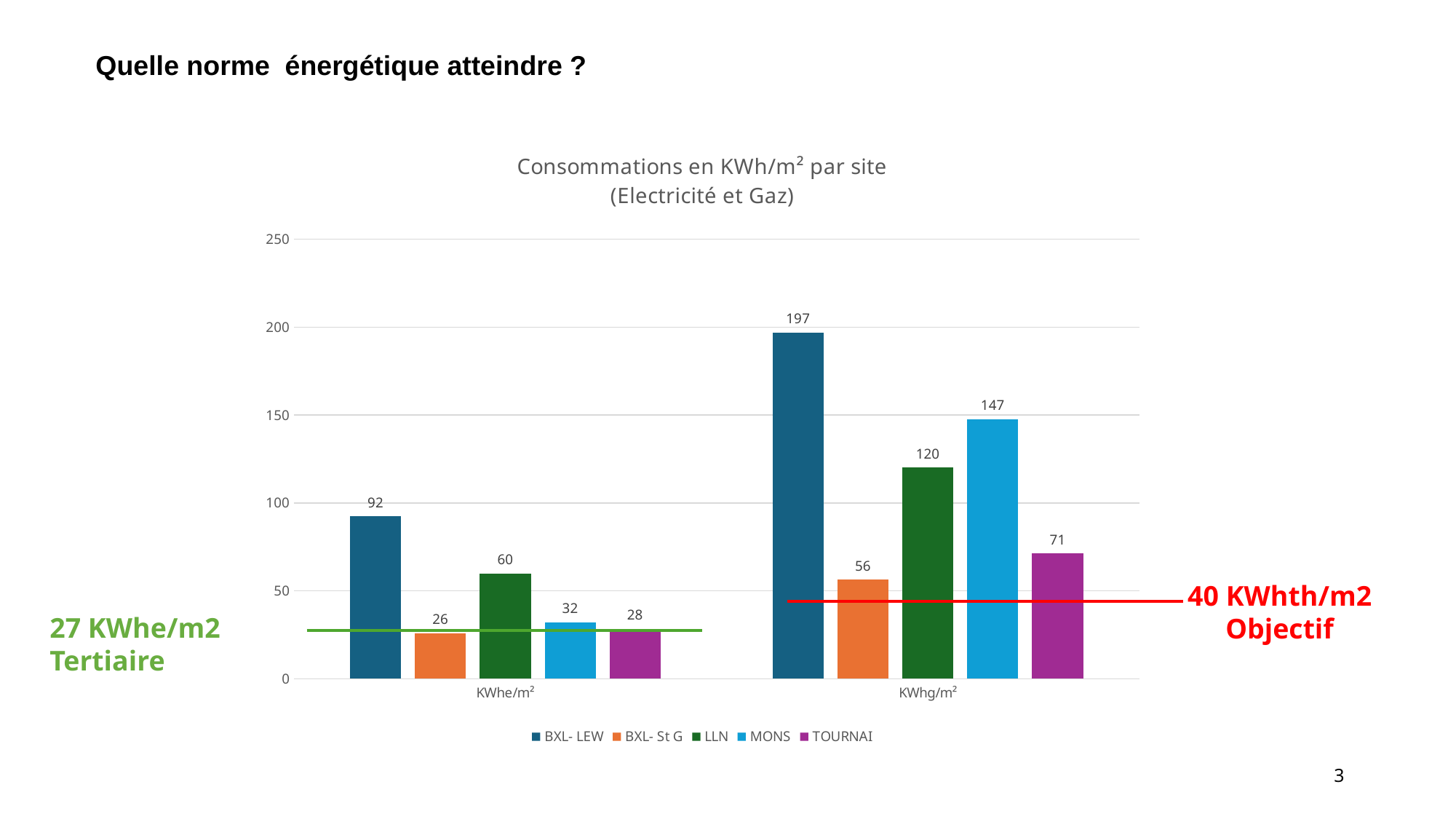
What is the difference between the KWhg/m² values for BXL- LEW and MONS? 50 How many series does the legend list? 5 What is the value for MONS in the KWhe/m² category? 32 Which is larger in the KWhe/m² category: LLN or MONS? LLN What is the value for TOURNAI in the KWhg/m² category? 71 How many categories are shown on the x axis? 2 What is the value for BXL- LEW in the KWhg/m² category? 197 Is the value for LLN in the KWhg/m² category greater or less than 100? greater Which site has the highest value in the KWhe/m² category? BXL- LEW What is the title of the chart? Consommations en KWh/m² par site (Electricité et Gaz) Which site has the lowest value in the KWhg/m² category? BXL- St G What kind of chart is shown on the slide? bar chart